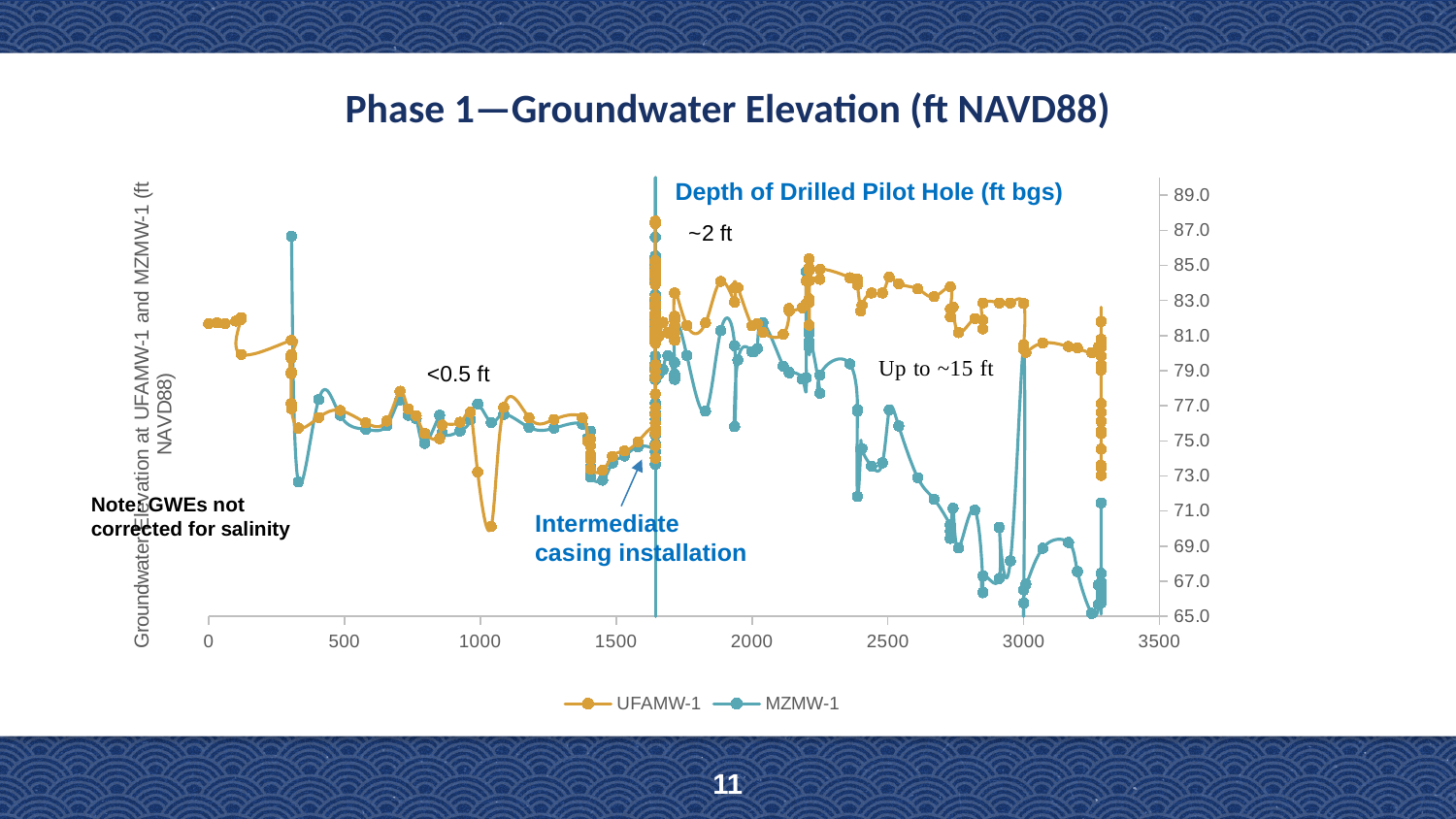
What kind of chart is shown on the slide? line chart Is the value for MZMW-1 at a depth of 2800 ft bgs greater or less than 73.0? less How many series does the legend list? 2 What is the title of the chart? Phase 1—Groundwater Elevation (ft NAVD88) Is the value for UFAMW-1 at a depth of 500 ft bgs greater or less than 79.0? less Between depths of 2000 and 3000 ft bgs, does the MZMW-1 series generally rise or fall? fall At a depth of 2000 ft bgs, which series has the lower groundwater elevation, UFAMW-1 or MZMW-1? MZMW-1 Which series reaches the lowest groundwater elevation anywhere on the chart? MZMW-1 What are the names of the two series in the legend? UFAMW-1 and MZMW-1 At a depth of 2500 ft bgs, which series has the higher groundwater elevation, UFAMW-1 or MZMW-1? UFAMW-1